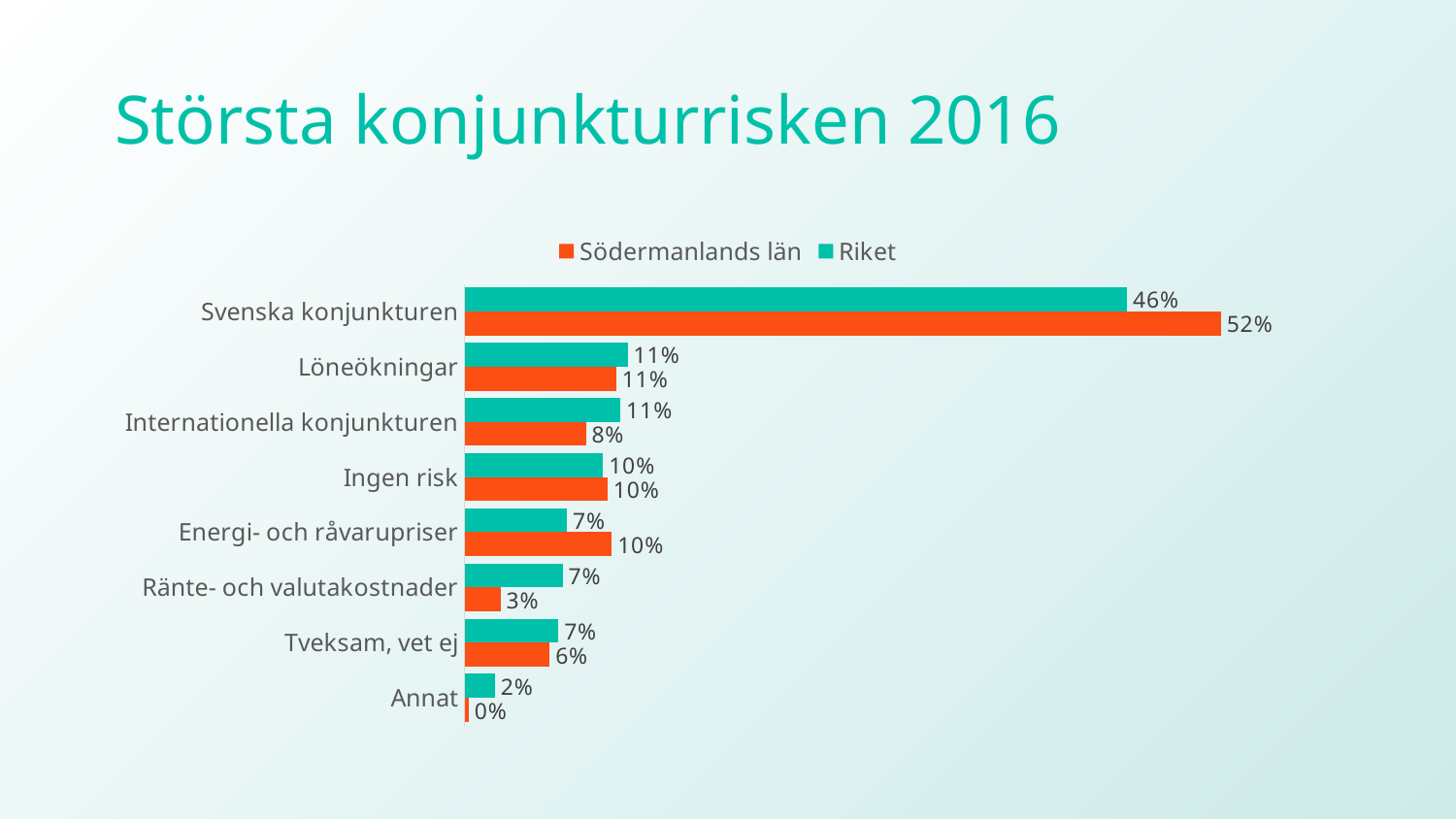
What is the value for Södermanlands län for Svenska konjunkturen? 52% Which category has the lowest value for Riket? Annat What is the difference between Södermanlands län and Riket for Svenska konjunkturen? 6% What kind of chart is shown on the slide? Bar chart Which category has the highest value for Södermanlands län? Svenska konjunkturen What is the value for Riket for Svenska konjunkturen? 46% How many series does the legend list? 2 What is the value for Riket for Annat? 2% How many categories are shown on the chart? 8 For Energi- och råvarupriser, which series has the larger value, Södermanlands län or Riket? Södermanlands län What is the title of the slide? Största konjunkturrisken 2016 What is the value for Södermanlands län for Ränte- och valutakostnader? 3%